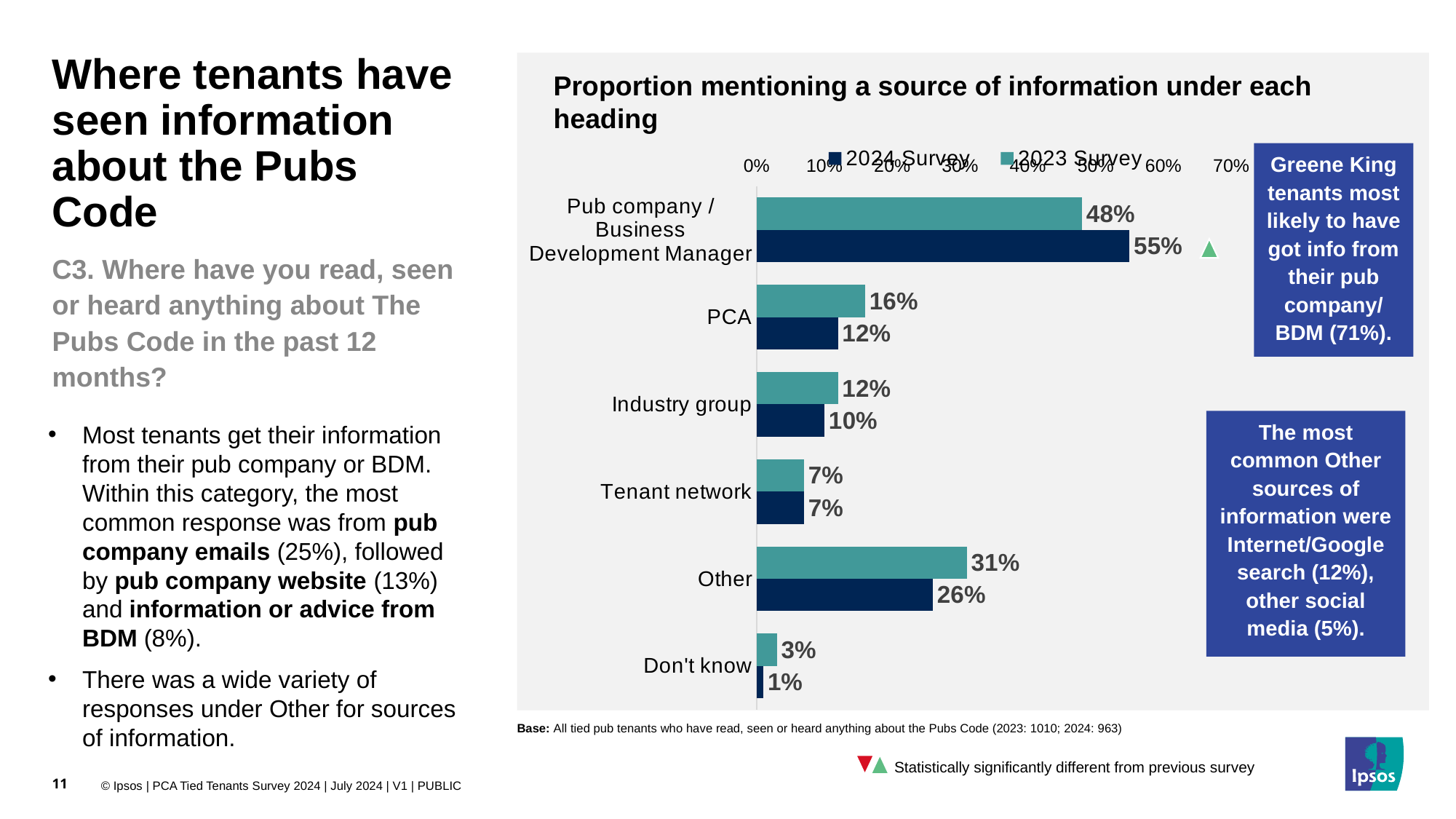
Which category has the highest 2024 Survey value? Pub company / Business Development Manager What is the title of the chart? Proportion mentioning a source of information under each heading How many categories are shown on the chart? 6 What is the difference between the 2024 Survey and 2023 Survey values for Pub company / Business Development Manager? 7 percentage points What is the 2024 Survey value for PCA? 12% Which category has the lowest 2024 Survey value? Don't know What is the 2024 Survey value for Pub company / Business Development Manager? 55% What kind of chart is shown on the slide? Bar chart Which is larger for PCA: the 2023 Survey value or the 2024 Survey value? 2023 Survey What is the 2023 Survey value for Other? 31% What is the 2023 Survey value for Don't know? 3% How many series does the legend list? 2